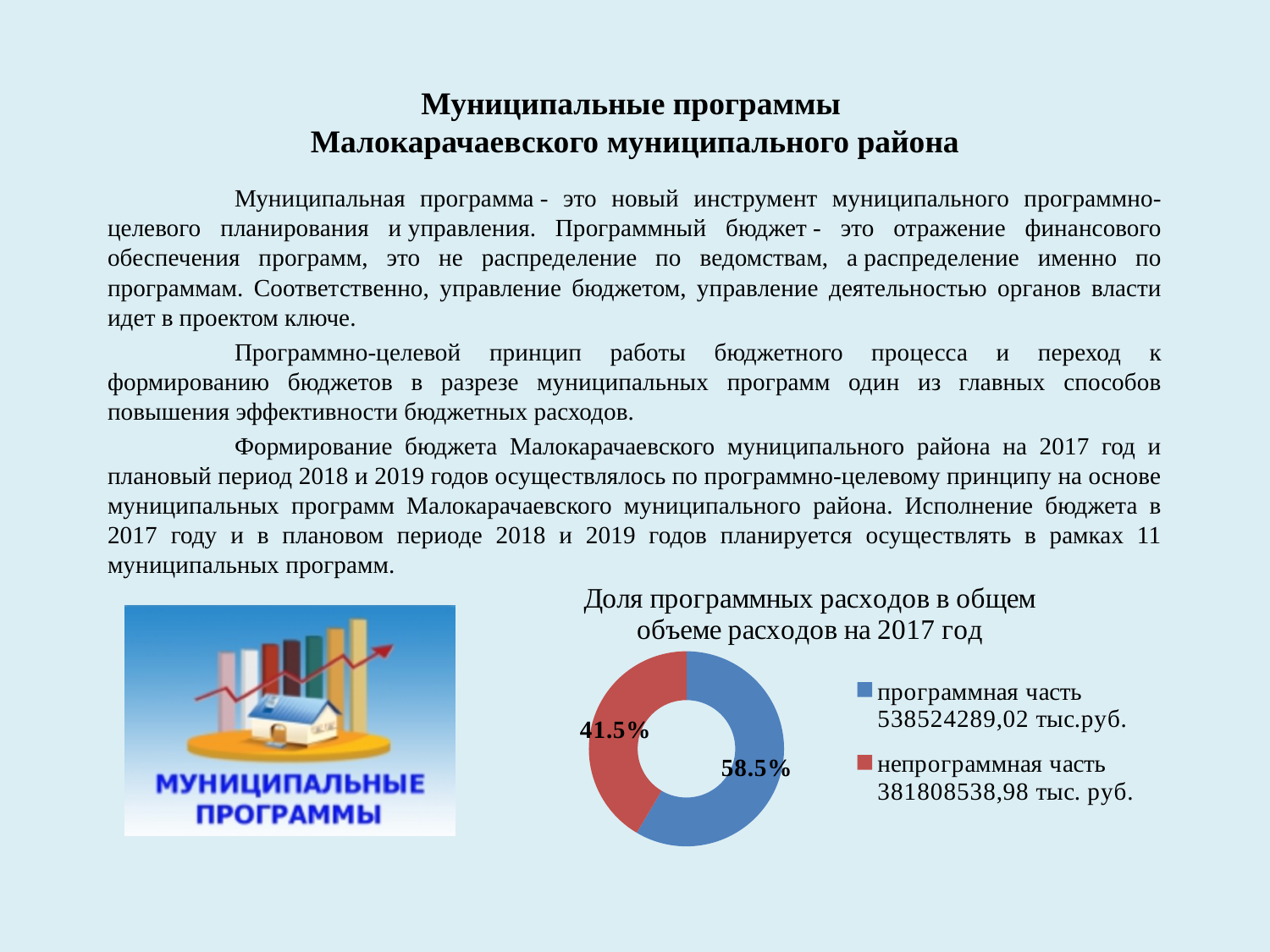
Which is larger in the doughnut chart: 'программная часть' or 'непрограммная часть'? программная часть What share of the doughnut chart does the 'программная часть' slice represent? 58.5% Which slice of the doughnut chart is the smallest? непрограммная часть How many entries does the legend of the chart list? 2 What share of the doughnut chart does the 'непрограммная часть' slice represent? 41.5% How many slices does the doughnut chart have? 2 Which slice of the doughnut chart is the largest? программная часть What amount does the legend give for 'программная часть'? 538524289,02 тыс.руб. By how many percentage points does the 'программная часть' slice exceed the 'непрограммная часть' slice? 17 percentage points What kind of chart is shown on the slide? doughnut (pie) chart What is the title of the chart on the slide? Доля программных расходов в общем объеме расходов на 2017 год Is the share of 'программная часть' greater or less than 50%? greater